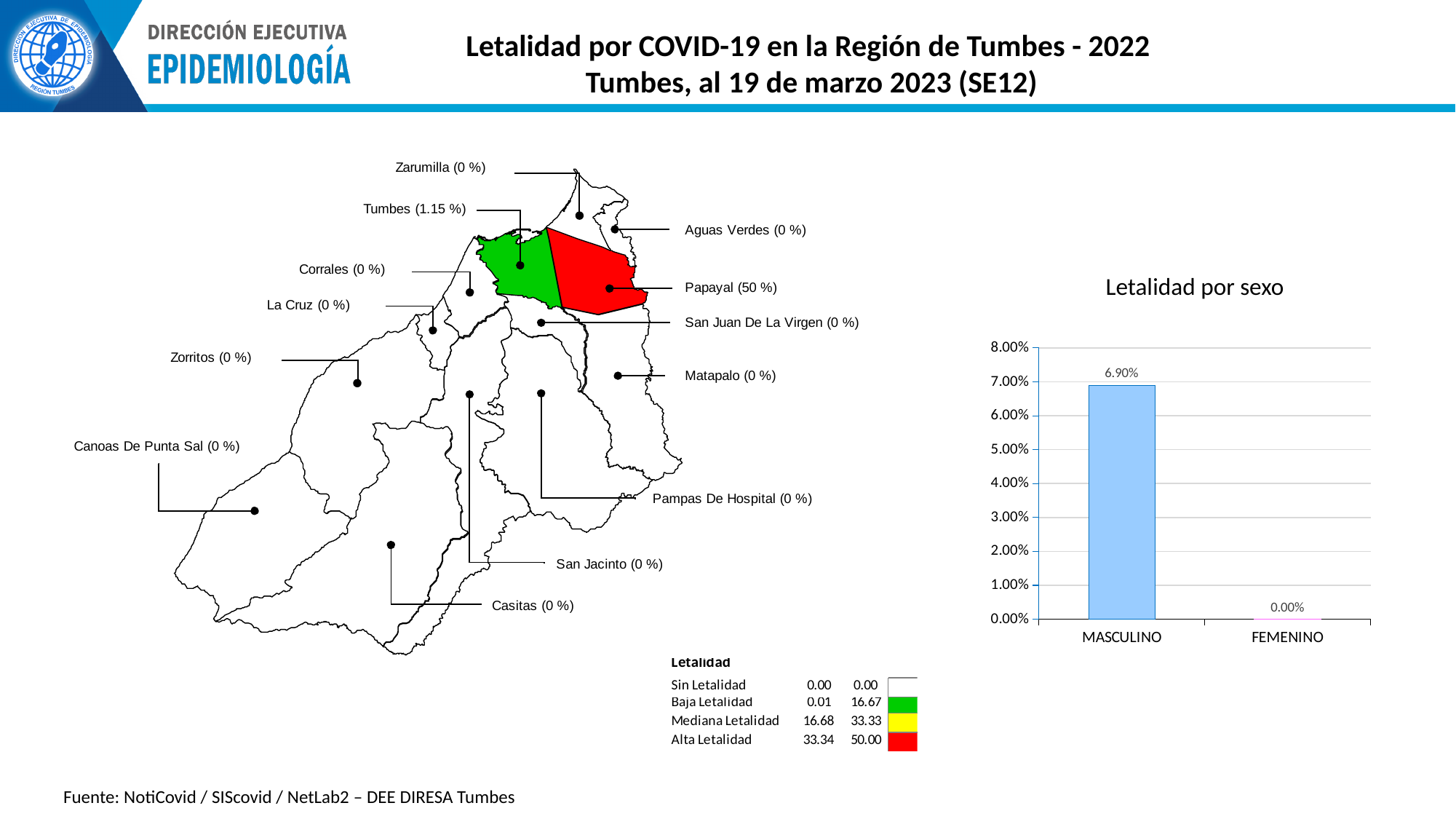
In the 'Letalidad por sexo' chart, which category has the lowest value? FEMENINO In the 'Letalidad por sexo' chart, what is the difference between the MASCULINO and FEMENINO values? 6.90% In the 'Letalidad por sexo' chart, is the value for MASCULINO greater or less than 5.00%? greater On the map on the left, what lethality percentage is shown for Papayal? 50 % How many categories are shown in the 'Letalidad por sexo' chart? 2 In the 'Letalidad por sexo' chart, which category has the highest value? MASCULINO In the 'Letalidad por sexo' chart, what is the value for FEMENINO? 0.00% What is the highest value shown on the vertical axis of the 'Letalidad por sexo' chart? 8.00% On the map on the left, what lethality percentage is shown for Tumbes? 1.15 % In the 'Letalidad por sexo' chart, what is the value for MASCULINO? 6.90% What kind of chart is 'Letalidad por sexo'? bar chart In the 'Letalidad por sexo' chart, is the value for MASCULINO greater or less than 7.00%? less